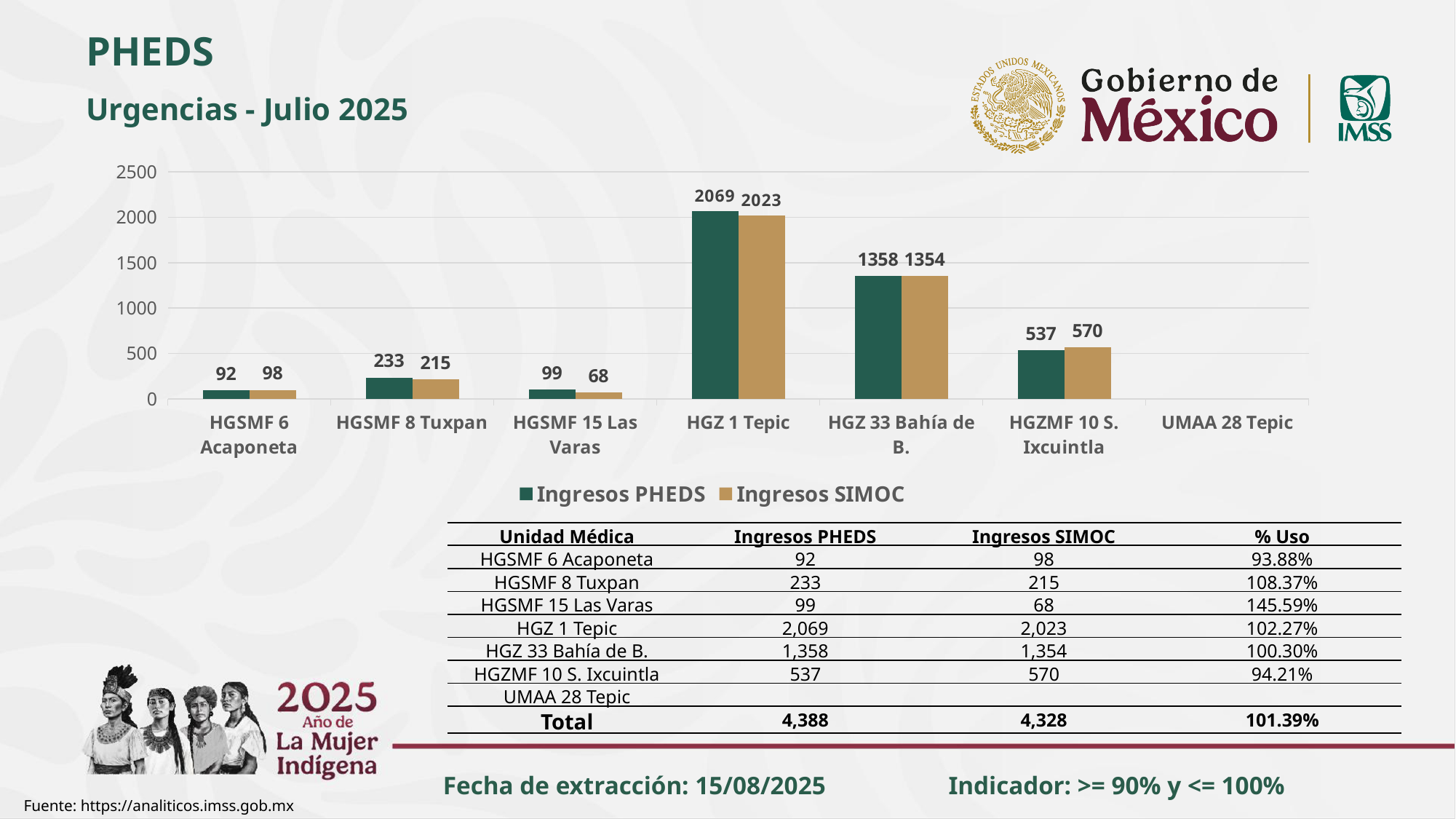
Among the units with bars shown, which has the lowest Ingresos SIMOC value? HGSMF 15 Las Varas What is the Ingresos SIMOC value for HGZMF 10 S. Ixcuintla? 570 For HGZMF 10 S. Ixcuintla, which is larger: Ingresos PHEDS or Ingresos SIMOC? Ingresos SIMOC What is the Ingresos SIMOC value for HGSMF 15 Las Varas? 68 How many units are listed on the x axis of the chart? 7 What is the difference between Ingresos PHEDS and Ingresos SIMOC for HGSMF 8 Tuxpan? 18 Which unit has the highest Ingresos PHEDS value? HGZ 1 Tepic Which series is shown in green in the chart? Ingresos PHEDS What type of chart is shown on the slide? Bar chart What is the Ingresos PHEDS value for HGZ 1 Tepic? 2069 How many series does the chart legend list? 2 Is the Ingresos PHEDS value for HGZ 33 Bahía de B. greater or less than 1000? greater